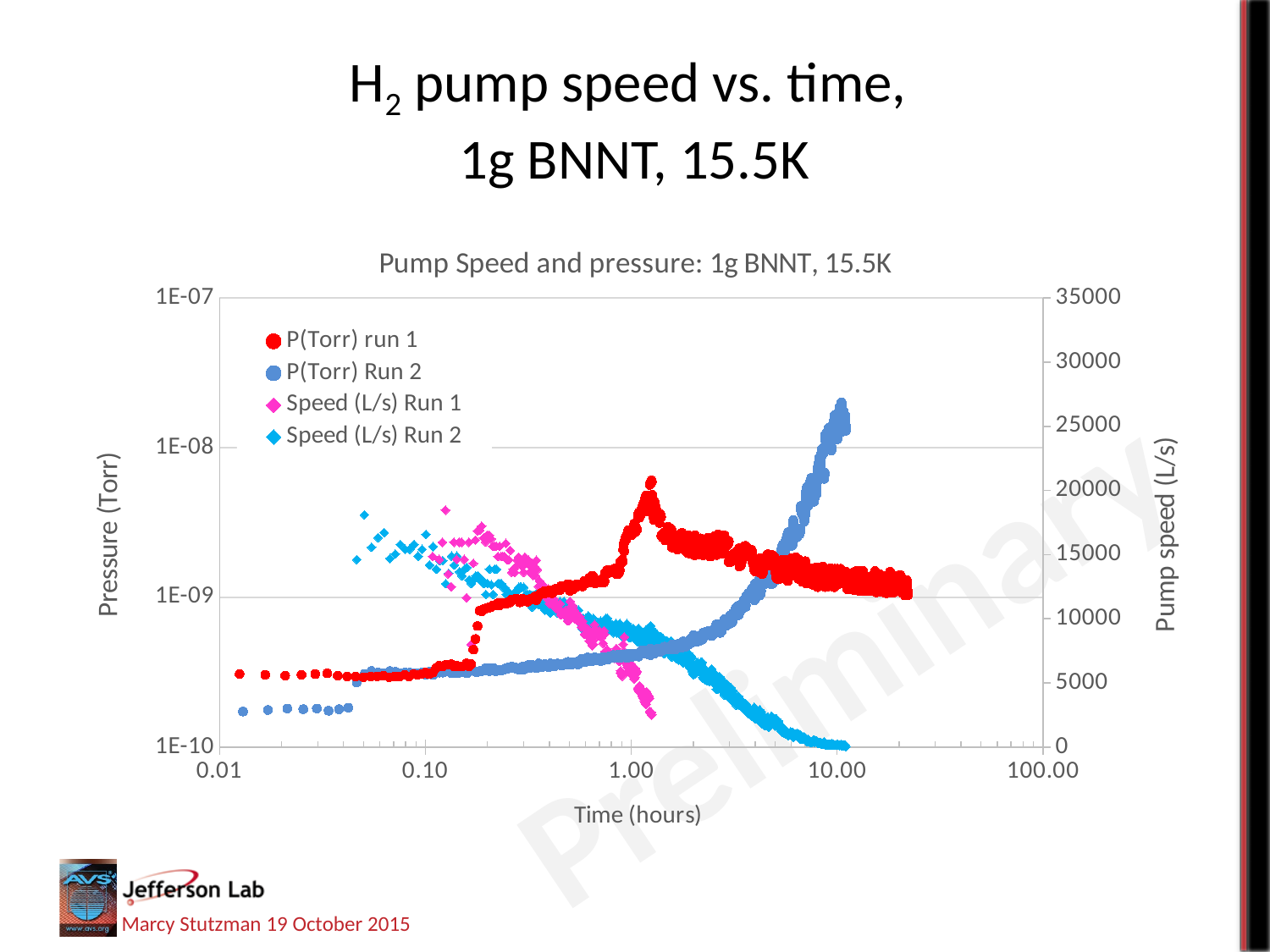
Which pressure series reaches the highest pressure on the chart? P(Torr) Run 2 Is the P(Torr) run 1 value at 0.01 hours greater or less than 1E-09? less Does the P(Torr) Run 2 series rise or fall as time increases? Rise What kind of chart is shown on the slide? Scatter chart Is the Speed (L/s) Run 2 value at 10.00 hours greater or less than 5000? less What is the label of the right-hand vertical axis? Pump speed (L/s) Is the P(Torr) Run 2 value at 10.00 hours greater or less than 1E-08? greater At 10.00 hours, which series has the higher pressure: P(Torr) run 1 or P(Torr) Run 2? P(Torr) Run 2 How many series does the chart legend list? 4 Does the Speed (L/s) Run 2 series rise or fall as time increases? Fall What is the title of the chart? Pump Speed and pressure: 1g BNNT, 15.5K